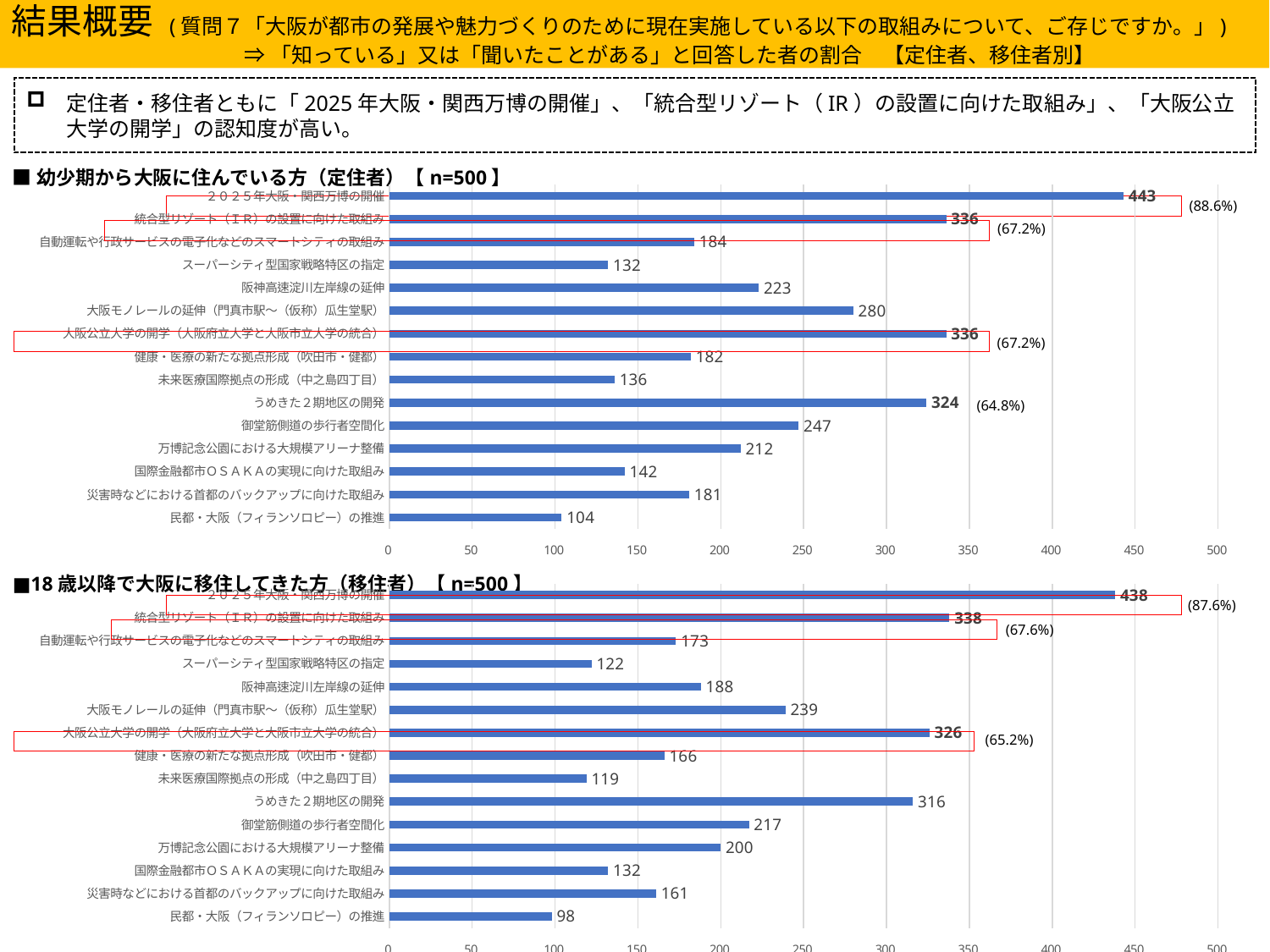
In the top chart (定住者), what is the difference between the values for 大阪モノレールの延伸 and 阪神高速淀川左岸線の延伸? 57 In the bottom chart (移住者), what is the difference between the values for 統合型リゾート（ＩＲ）の設置に向けた取組み and 大阪公立大学の開学? 12 In the bottom chart (移住者), what is the value for 民都・大阪（フィランソロピー）の推進? 98 In the bottom chart (移住者), which category has the highest value? ２０２５年大阪・関西万博の開催 In the bottom chart (移住者), what is the value for うめきた２期地区の開発? 316 In the top chart (定住者), what is the value for 2025年大阪・関西万博の開催? 443 How many categories are plotted in the top chart (定住者)? 15 What kind of chart is the bottom chart (移住者)? Bar chart What is the sample size (n) shown for the top chart (定住者)? n=500 In the bottom chart (移住者), which is larger: the value for 御堂筋側道の歩行者空間化 or 万博記念公園における大規模アリーナ整備? 御堂筋側道の歩行者空間化 In the top chart (定住者), what percentage is shown in parentheses next to うめきた２期地区の開発? (64.8%) In the top chart (定住者), which category has the lowest value? 民都・大阪（フィランソロピー）の推進